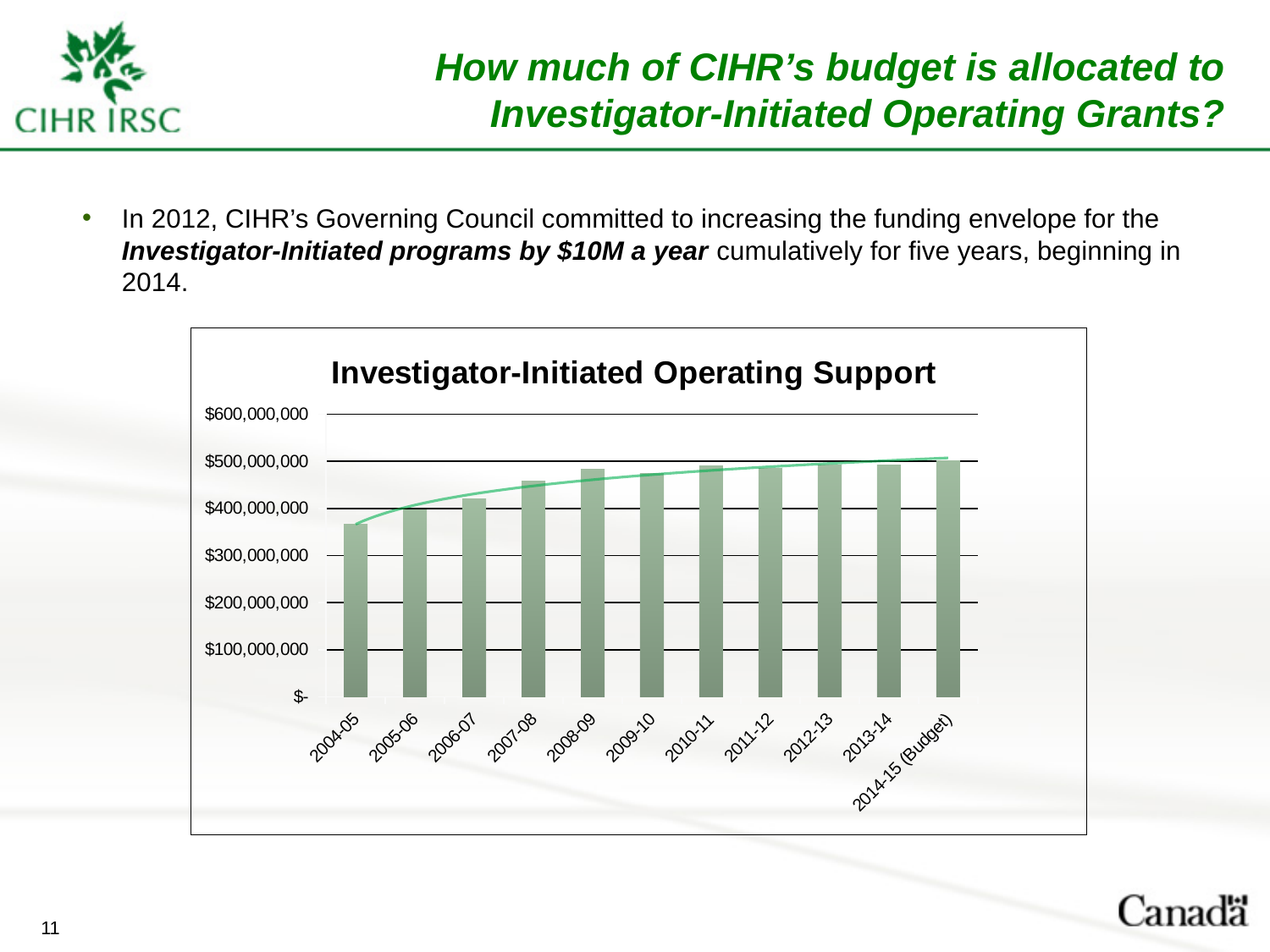
Which is larger, the value for 2004-05 or the value for 2008-09? 2008-09 Which fiscal year has the lowest Investigator-Initiated Operating Support? 2004-05 What type of chart is shown on the slide? bar chart Is the value for 2006-07 greater or less than $400,000,000? greater Is the value for 2007-08 greater or less than $400,000,000? greater How many fiscal years are shown on the x axis of the chart? 11 Do the values generally rise or fall from 2004-05 to 2014-15 (Budget)? rise Which is larger, the value for 2005-06 or the value for 2007-08? 2007-08 Is the value for 2008-09 greater or less than $500,000,000? less What is the title of the chart? Investigator-Initiated Operating Support What is the label of the last category on the x axis? 2014-15 (Budget)